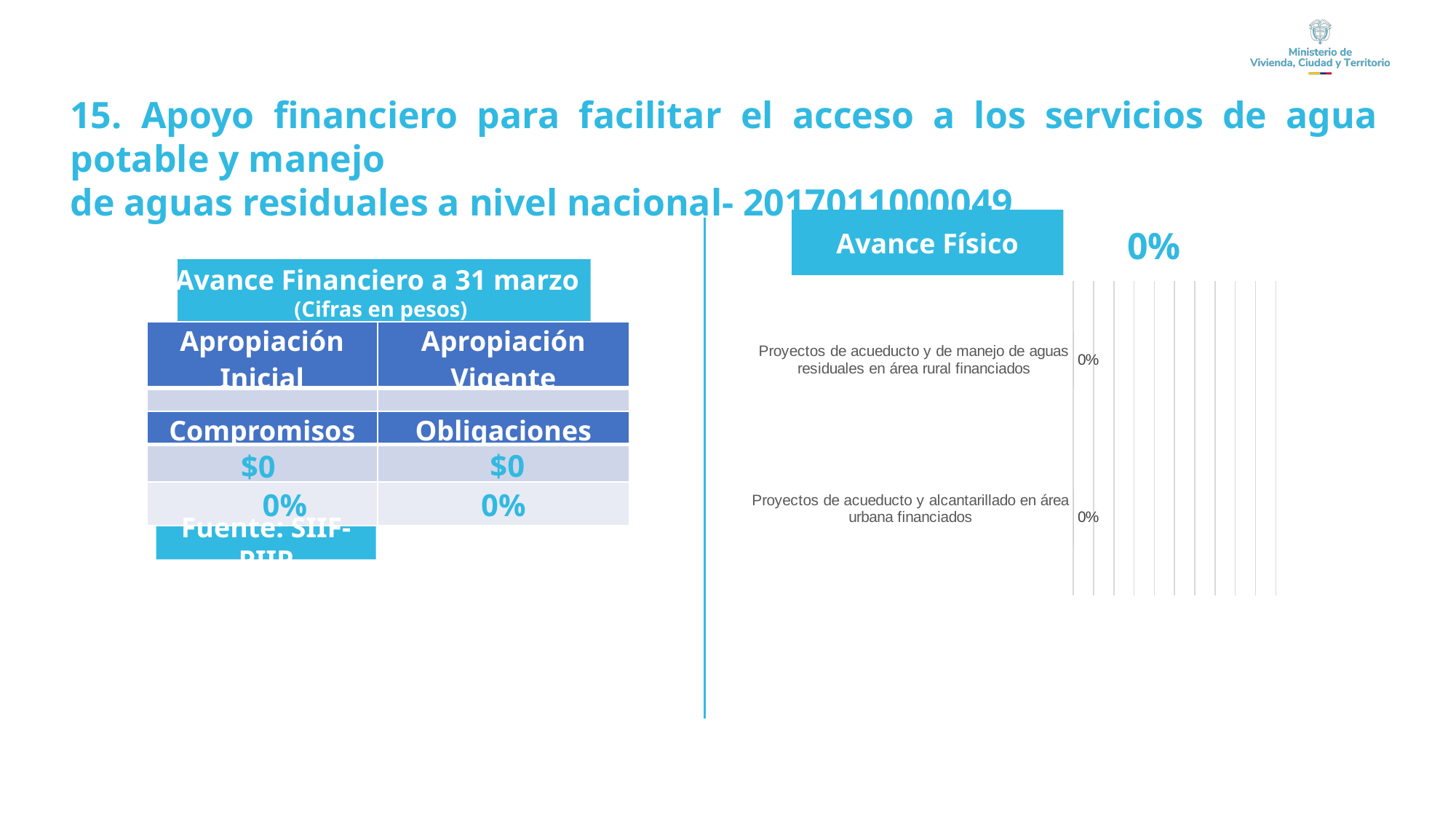
What is the title of the chart on the right side of the slide? Avance Físico In the Avance Físico chart, what is the difference between the value for the rural projects category and the value for the urban projects category? 0% How many categories does the Avance Físico chart show? 2 What overall percentage is shown next to the Avance Físico chart title? 0% What kind of chart is the Avance Físico chart? bar chart In the Avance Físico chart, what is the value for 'Proyectos de acueducto y de manejo de aguas residuales en área rural financiados'? 0% In the Avance Físico chart, what is the value for 'Proyectos de acueducto y alcantarillado en área urbana financiados'? 0%